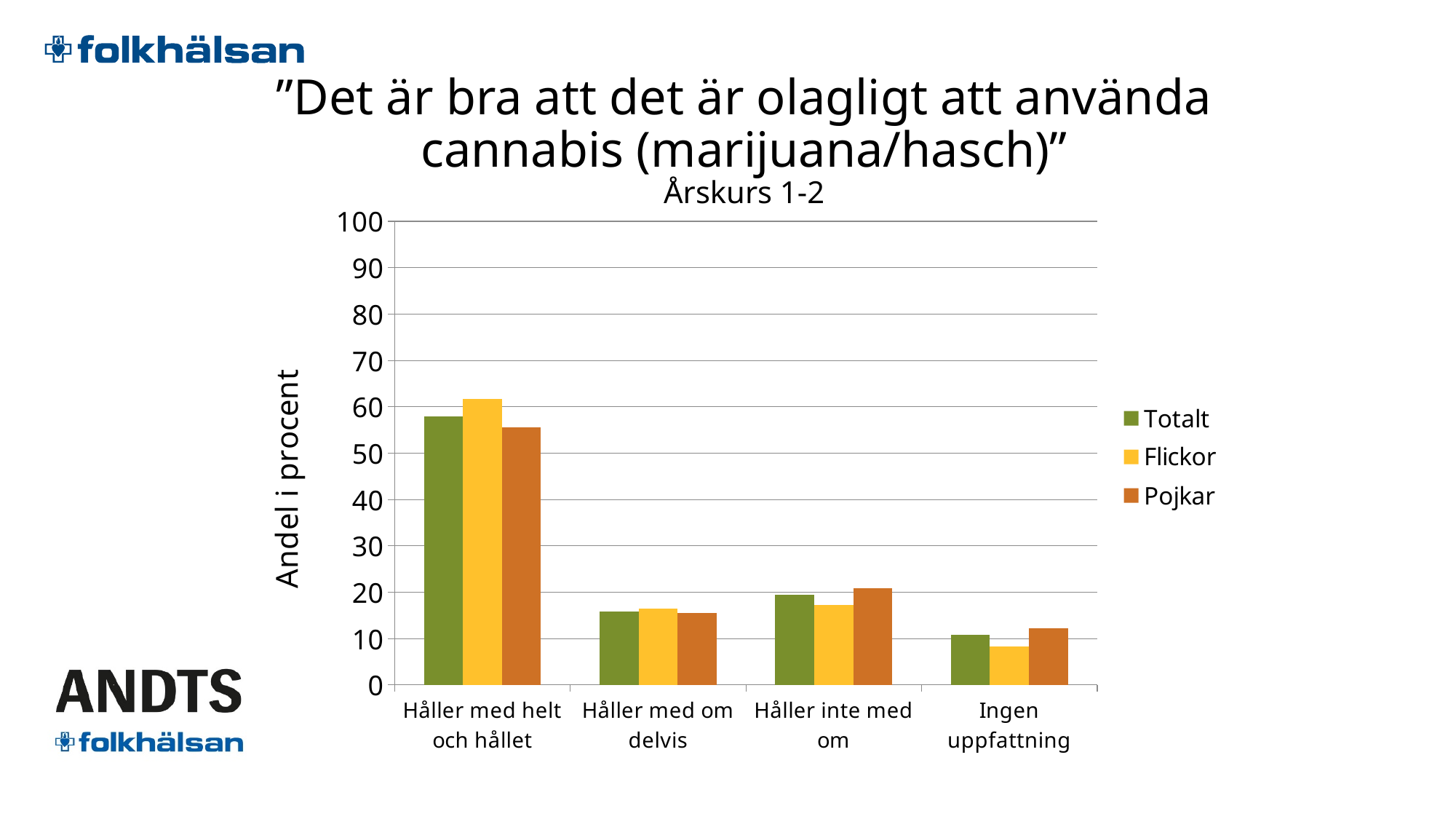
How many series does the legend list? 3 Which category has the lowest value for Flickor? Ingen uppfattning How many response categories are shown on the x axis? 4 Which school years does the chart subtitle say the data covers? Årskurs 1-2 Is the value for Pojkar in 'Håller med helt och hållet' greater or less than 60? less Which category has the highest value for Totalt? Håller med helt och hållet In 'Håller inte med om', which is larger: Flickor or Pojkar? Pojkar Is the value for Flickor in 'Ingen uppfattning' greater or less than 10? less What is the label of the y axis? Andel i procent Is the value for Flickor in 'Håller med helt och hållet' greater or less than 50? greater In 'Håller med helt och hållet', which is larger: Flickor or Pojkar? Flickor What kind of chart is shown on the slide? bar chart